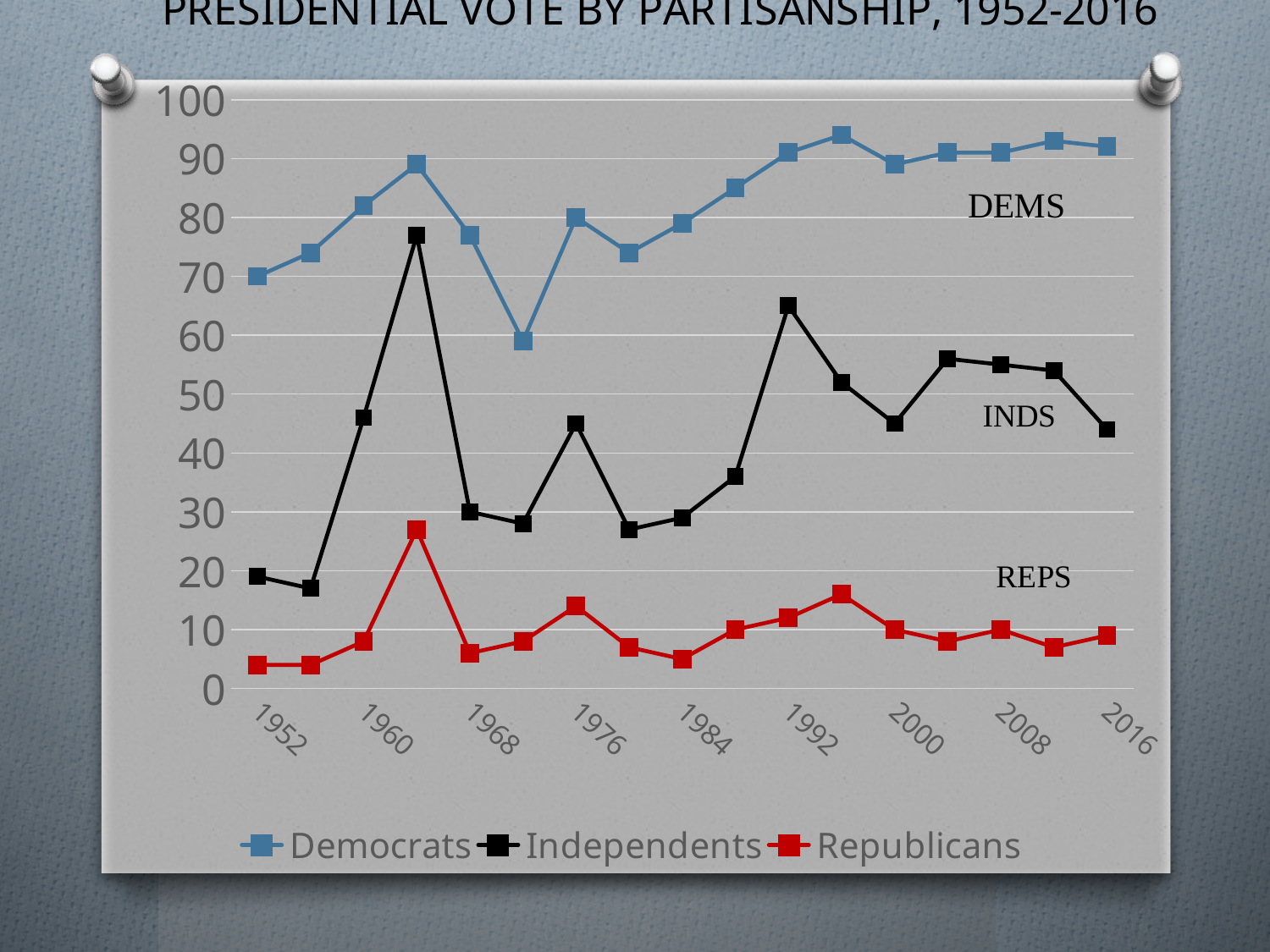
How many years are labelled on the x axis? 9 Which is larger: the Independents value in 1992 or in 2000? 1992 How many series does the legend list? 3 What kind of chart is shown on the slide? line chart Is the value for Republicans in 1976 greater or less than 10? greater Do the Democrats values rise or fall from 1984 to 1992? rise Is the value for Independents in 1992 greater or less than 60? greater Which series has the highest value in 2016? Democrats Which series has the lowest value in 1952? Republicans Is the value for Democrats in 1968 greater or less than 70? greater What is the value for Democrats in 1952? 70 What colour is the Republicans line? red